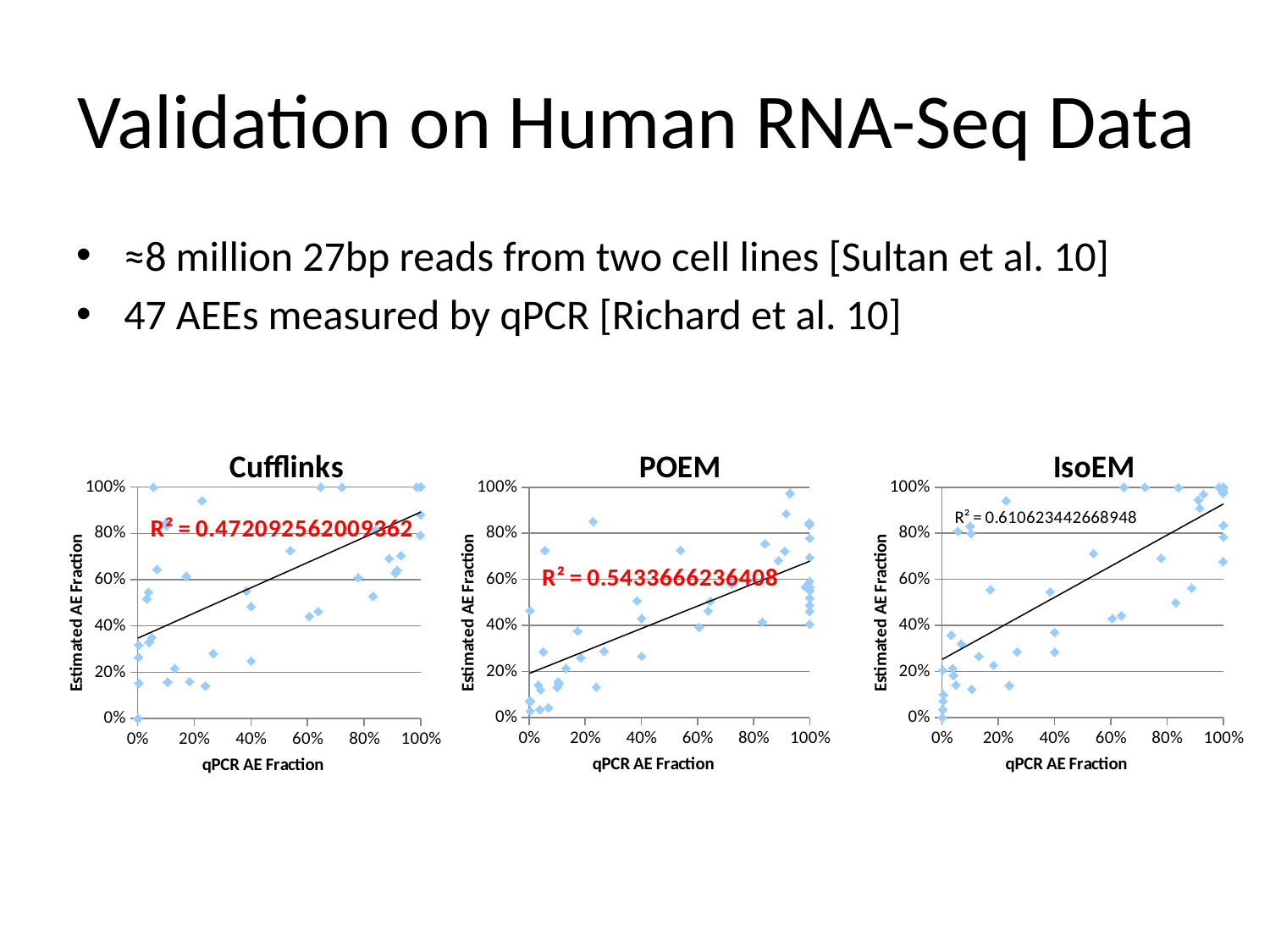
What R² value is printed on the POEM chart? 0.5433666236408 In the IsoEM chart, does the fitted trend line rise or fall as qPCR AE Fraction increases? rises What is the title of the middle chart on the slide? POEM What R² value is printed on the Cufflinks chart? 0.472092562009362 What R² value is printed on the IsoEM chart? 0.610623442668948 What is the y-axis title of the Cufflinks chart? Estimated AE Fraction What is the x-axis title of the POEM chart? qPCR AE Fraction Which of the three charts shows the highest R² value? IsoEM What kind of chart is the Cufflinks chart? scatter chart Is the R² value on the POEM chart larger or smaller than the R² value on the Cufflinks chart? larger How many charts are shown on the slide? 3 Which of the three charts shows the lowest R² value? Cufflinks